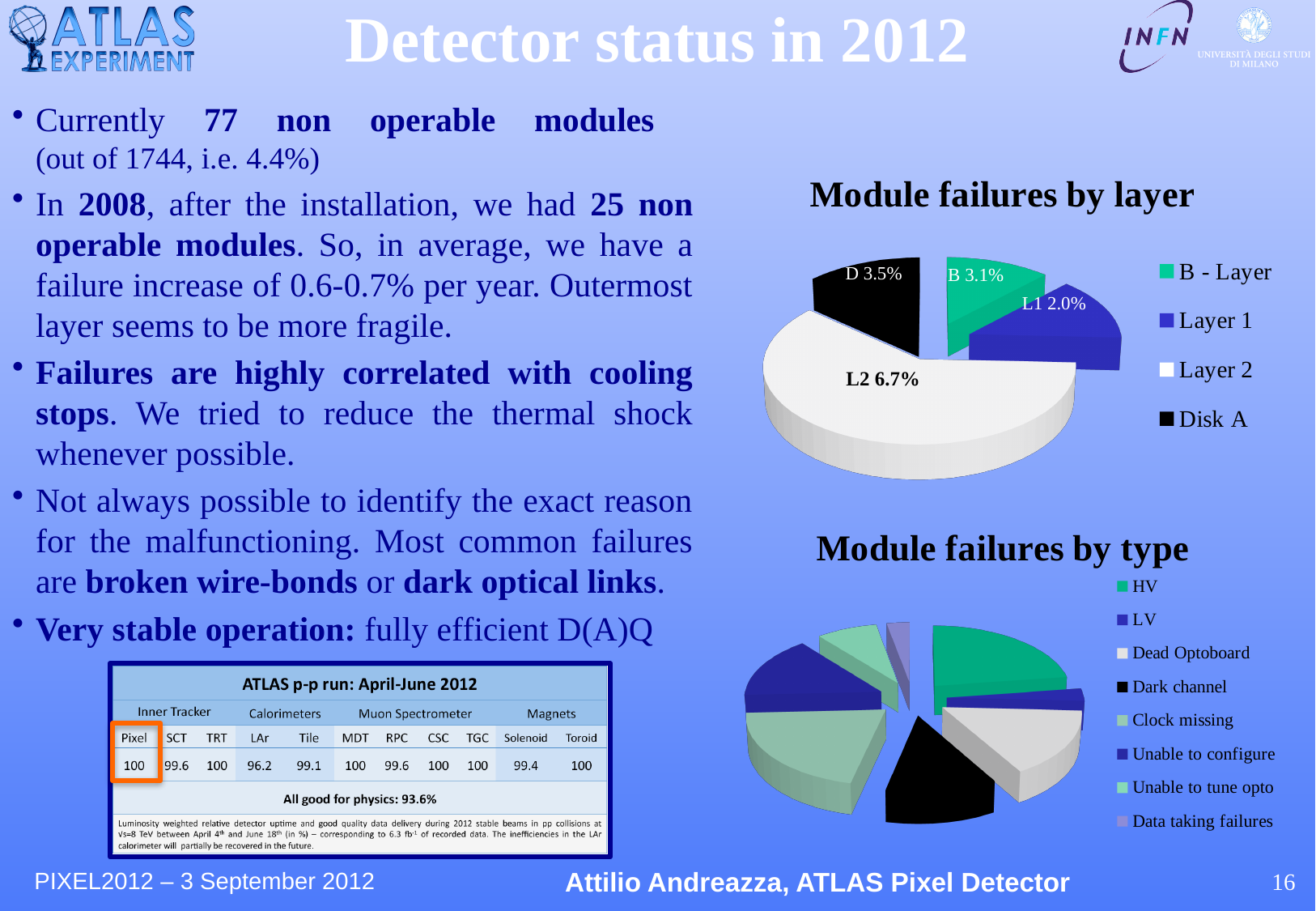
How many entries does the legend of the 'Module failures by type' chart list? 8 In the 'Module failures by layer' chart, which is larger, the Disk A value or the B-Layer value? Disk A In the 'Module failures by layer' chart, what value is shown for Layer 1? 2.0% How many slices does the 'Module failures by layer' chart have? 4 In the 'Module failures by layer' chart, what value is shown for the B-Layer? 3.1% In the 'Module failures by layer' chart, which layer has the largest slice? Layer 2 In the 'Module failures by type' chart, which legend entry is shown in black? Dark channel In the 'Module failures by layer' chart, what value is shown for Disk A? 3.5% In the 'Module failures by layer' chart, what is the difference between the Layer 2 value and the Layer 1 value? 4.7% In the 'Module failures by layer' chart, what value is shown for Layer 2? 6.7% What kind of chart is 'Module failures by type'? Pie chart